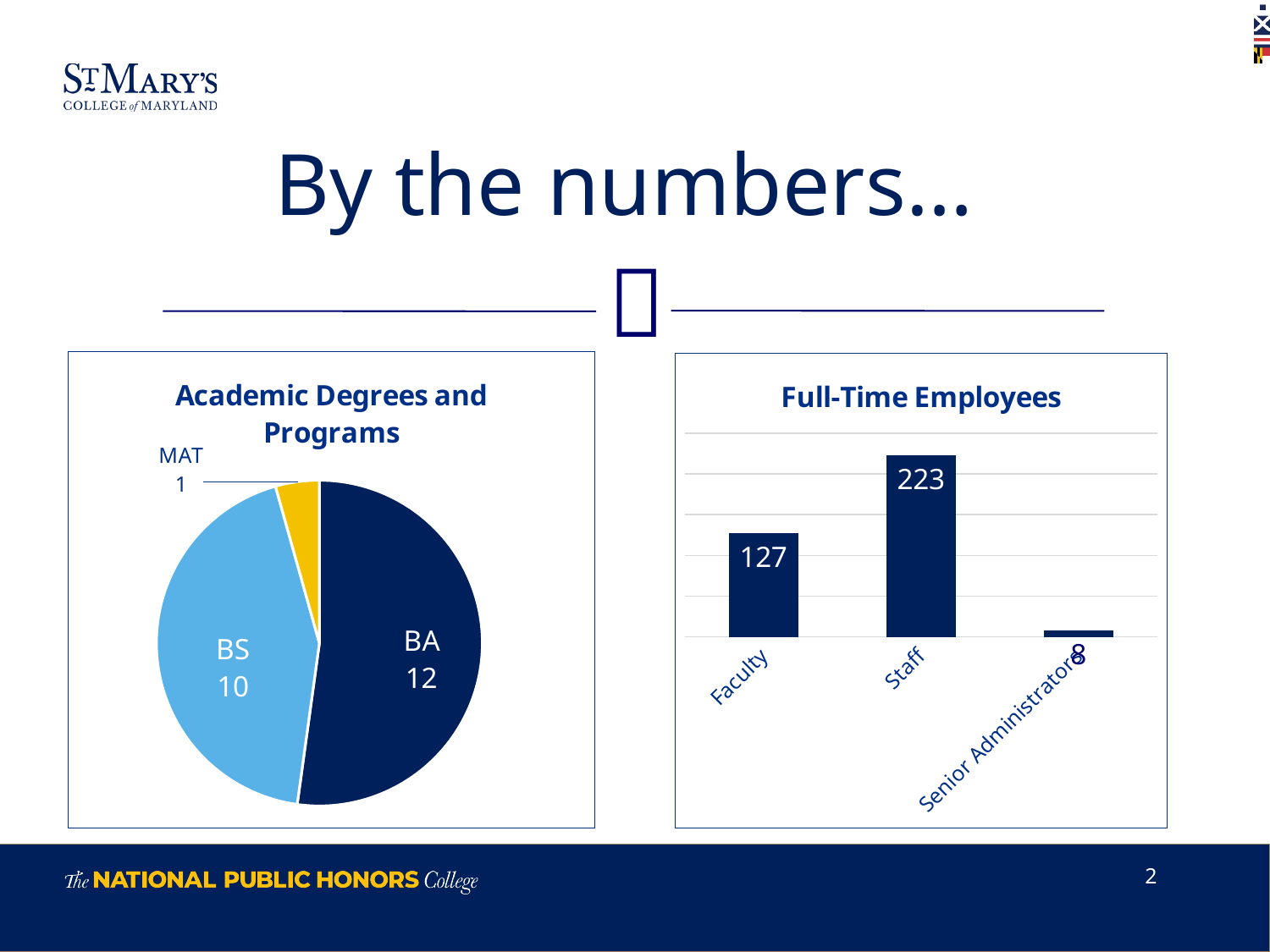
In the Full-Time Employees chart, how many full-time Staff are there? 223 In the Academic Degrees and Programs chart, what is the difference between the BA and BS values? 2 In the Full-Time Employees chart, what is the value for Faculty? 127 In the Academic Degrees and Programs chart, which category has the largest slice? BA In the Academic Degrees and Programs chart, how many BA programs are shown? 12 In the Academic Degrees and Programs chart, which category has the smallest slice? MAT In the Academic Degrees and Programs chart, what is the value for MAT? 1 What kind of chart is the Academic Degrees and Programs chart? Pie chart In the Academic Degrees and Programs chart, what is the value for BS? 10 In the Full-Time Employees chart, what is the difference between Staff and Faculty? 96 In the Academic Degrees and Programs chart, how many categories are shown? 3 What kind of chart is the Full-Time Employees chart? Bar chart